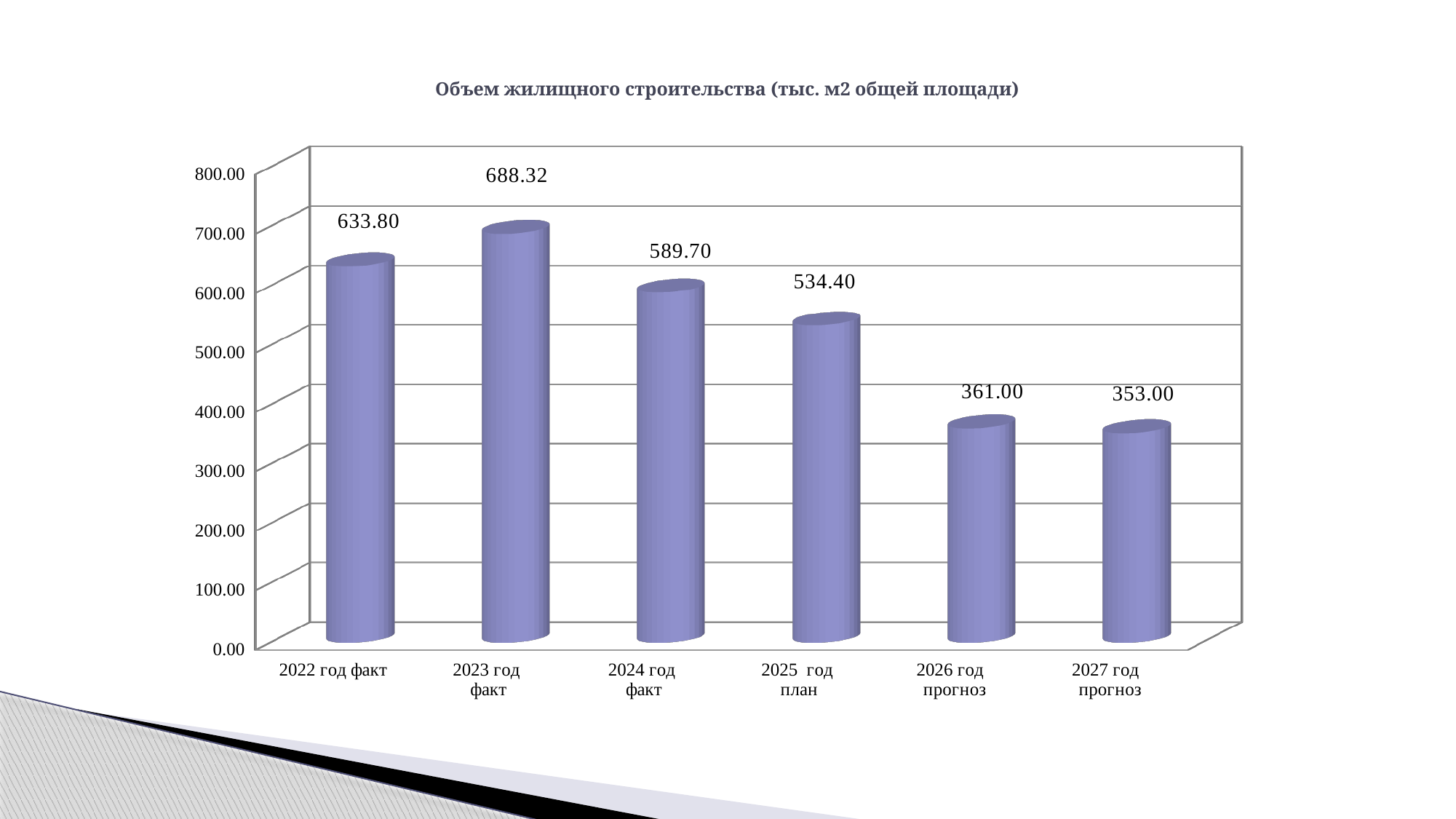
What is the value for 2027 год прогноз? 353.00 What is the title of the chart? Объем жилищного строительства (тыс. м2 общей площади) What is the value for 2025 год план? 534.40 What kind of chart is shown on the slide? bar chart Which category has the highest value? 2023 год факт Which is larger, the value for 2024 год факт or the value for 2025 год план? 2024 год факт Is the value for 2026 год прогноз greater or less than 400.00? less What is the difference between the values for 2022 год факт and 2024 год факт? 44.10 What is the value for 2023 год факт? 688.32 Which category has the lowest value? 2027 год прогноз What is the difference between the values for 2026 год прогноз and 2027 год прогноз? 8.00 How many categories are shown on the x axis? 6